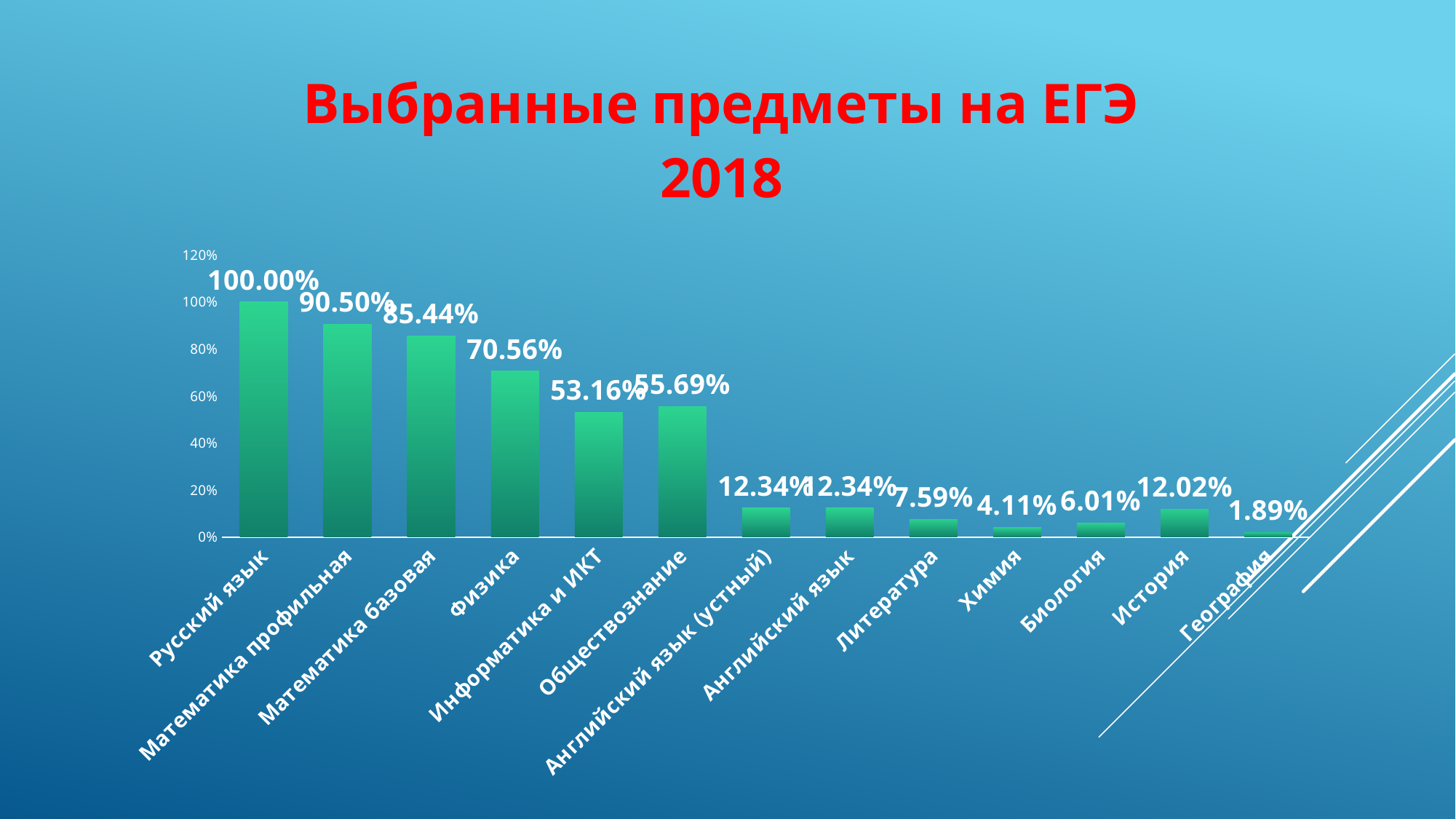
Which subject has the lowest value? География What is the value for Физика? 70.56% Is the value for Физика greater or less than 60%? greater Which subject has the highest value? Русский язык What is the value for Химия? 4.11% What is the title of the slide? Выбранные предметы на ЕГЭ 2018 What is the value for Обществознание? 55.69% What kind of chart is shown on the slide? Bar chart Which is larger, the value for Информатика и ИКТ or the value for Обществознание? Обществознание What is the difference between the values for Математика профильная and Математика базовая? 5.06% What is the value for История? 12.02% How many subjects are shown on the chart? 13